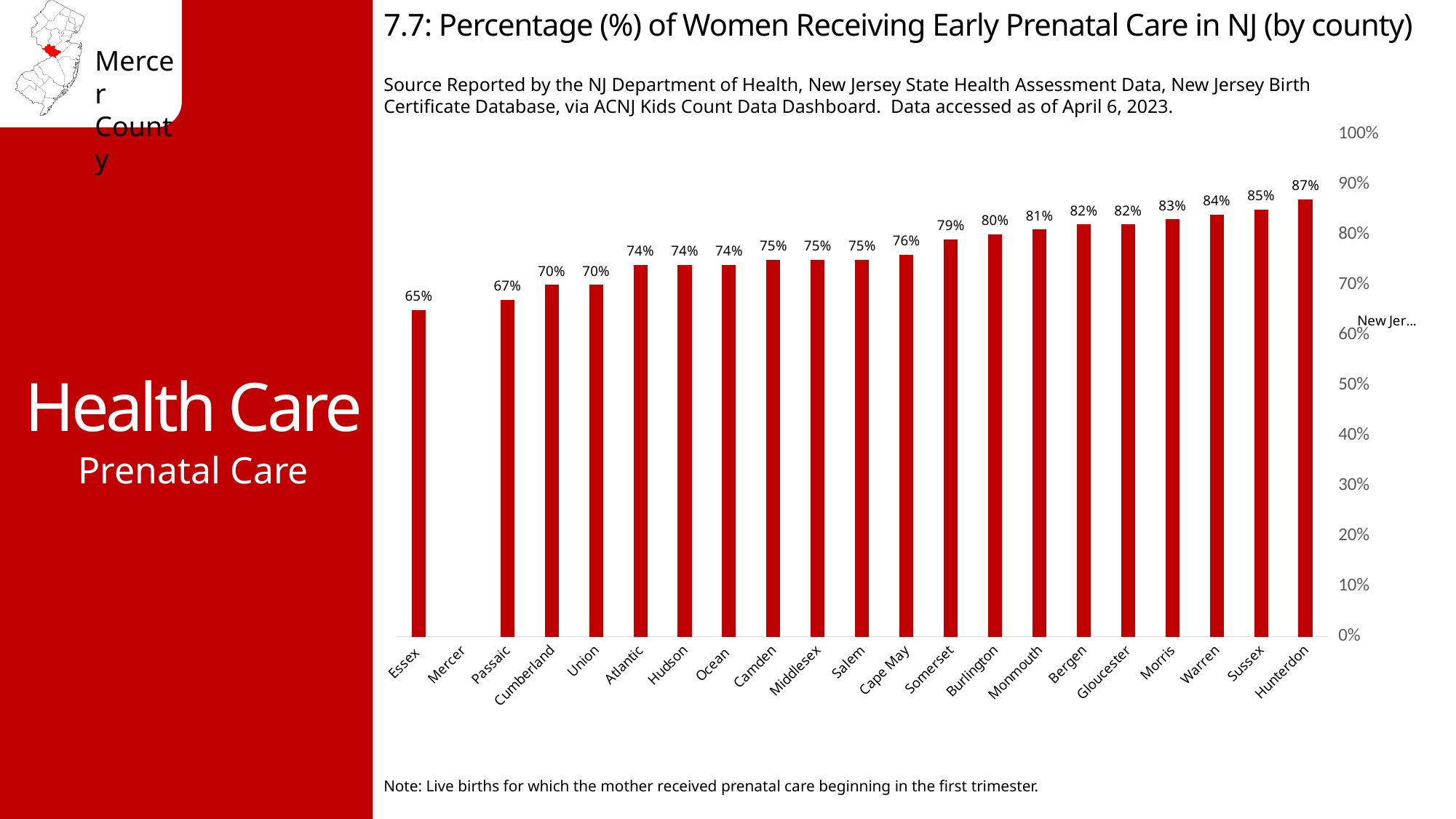
Is the value for Somerset greater or less than 80%? less What kind of chart is shown? Bar chart What is the difference between the values for Hunterdon and Essex? 22 percentage points What is the value for Essex? 65% What is the value for Hunterdon? 87% Which county has the highest value? Hunterdon What is the value for Somerset? 79% Which county has the lowest labelled value? Essex How many counties are labelled on the x axis? 21 Which is larger, the value for Passaic or the value for Burlington? Burlington What is the value for Cape May? 76% Do the values generally rise or fall from left to right along the x axis? Rise